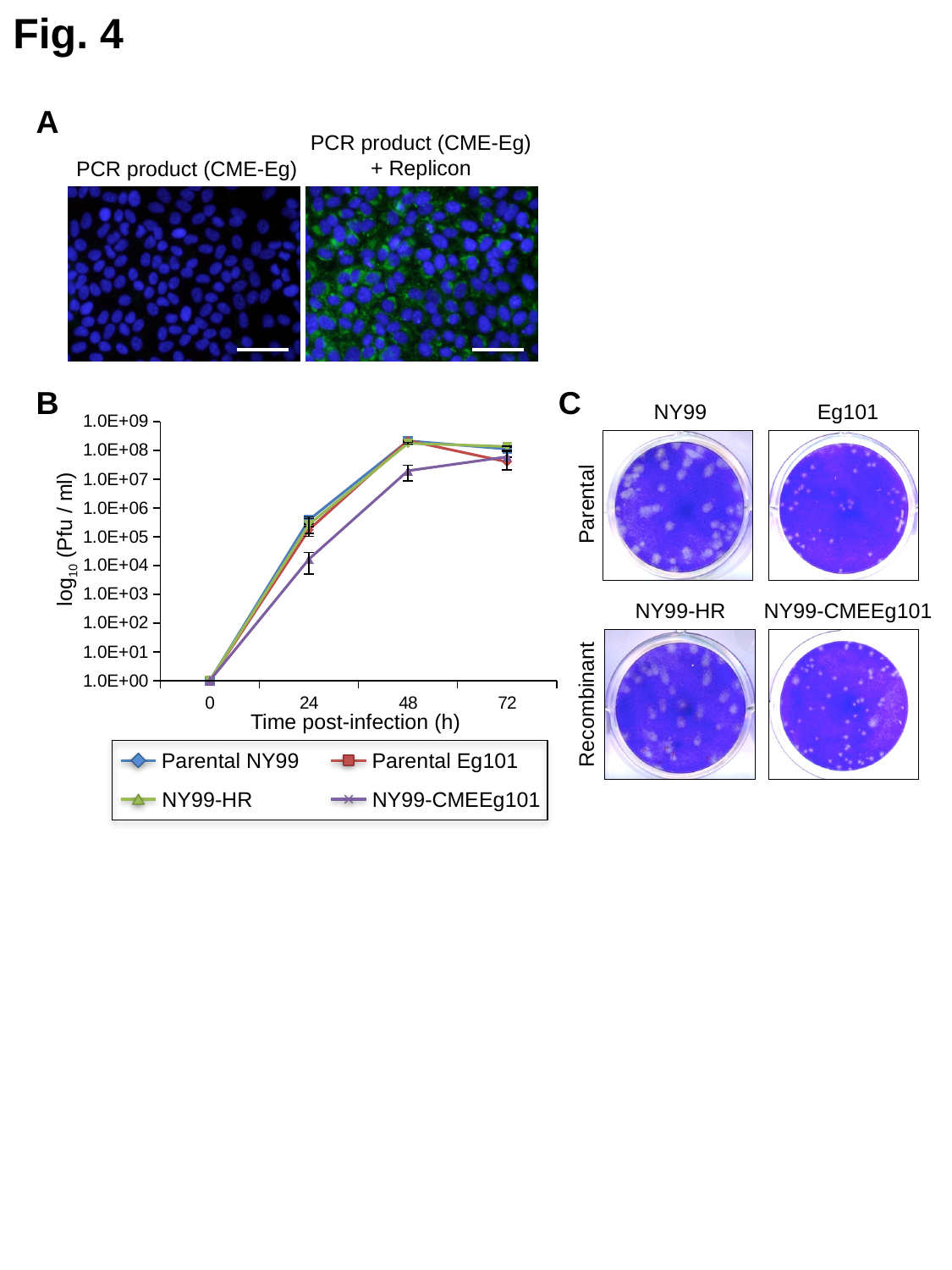
In the chart in panel B, is the value for NY99-CMEEg101 at 24 h greater or less than 1.0E+03? greater In the chart in panel B, is the value for NY99-CMEEg101 at 24 h greater or less than 1.0E+05? less In the chart in panel B, which series has the lowest value at 24 h post-infection? NY99-CMEEg101 In the chart in panel B, what is the label of the x axis? Time post-infection (h) In the chart in panel B, do the values for NY99-HR rise or fall from 0 h to 48 h post-infection? rise In the chart in panel B, is the value for Parental NY99 at 48 h greater or less than 1.0E+08? greater In the chart in panel B, how many series does the legend list? 4 In the chart in panel B, what is the value for Parental NY99 at 0 h post-infection? 1.0E+00 What kind of chart is shown in panel B? line chart In the chart in panel B, how many time points are plotted along the x axis? 4 In the chart in panel B, which is larger at 24 h post-infection: Parental NY99 or NY99-CMEEg101? Parental NY99